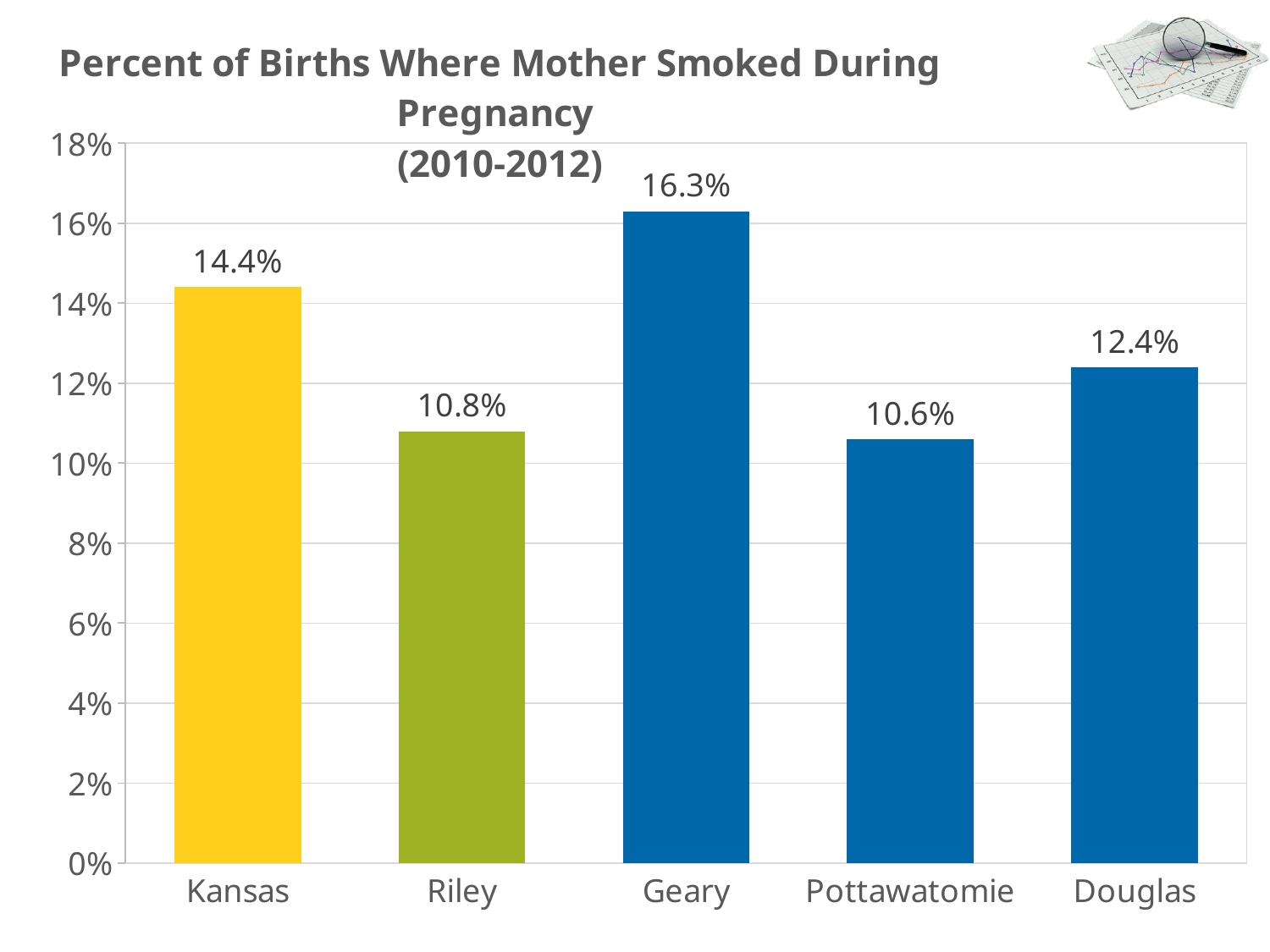
How many categories are shown on the x axis? 5 Is the value for Riley greater or less than 12%? less Which category has the lowest value? Pottawatomie What is the value for Geary? 16.3% What is the value for Douglas? 12.4% What is the value for Pottawatomie? 10.6% What kind of chart is shown on the slide? bar chart Which is larger, the value for Riley or the value for Douglas? Douglas Which category has the highest value? Geary What is the title of the chart? Percent of Births Where Mother Smoked During Pregnancy (2010-2012) What is the value for Kansas? 14.4% What is the difference between the values for Geary and Kansas? 1.9%